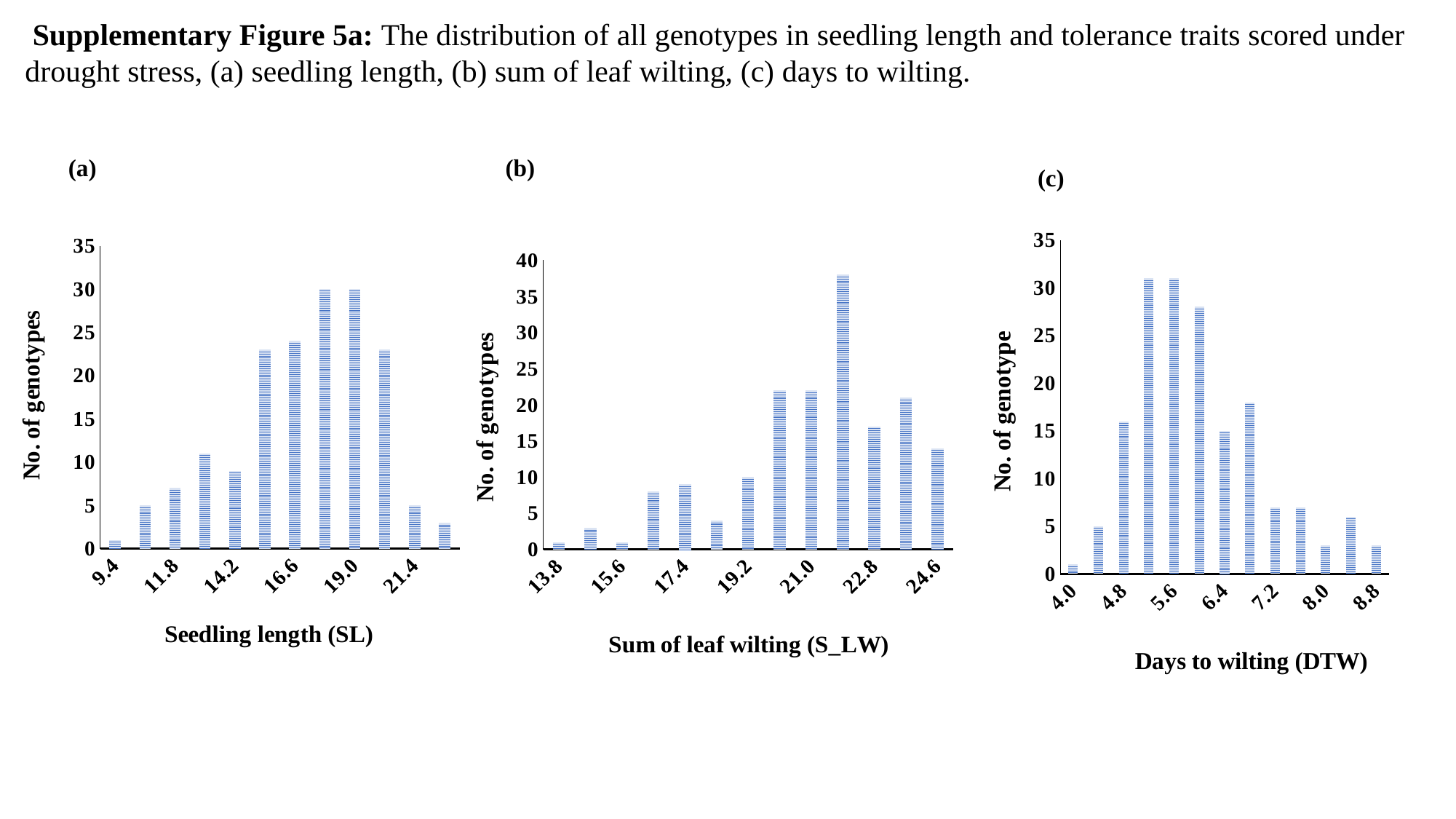
What kind of chart is chart (a), Seedling length (SL)? bar chart In chart (a), Seedling length (SL), is the number of genotypes at 19.0 greater or less than 25? greater In chart (a), Seedling length (SL), which labelled seedling length has the lowest number of genotypes? 9.4 In chart (a), Seedling length (SL), which has more genotypes: seedling length 19.0 or 11.8? 19.0 How many bars are plotted in chart (b), Sum of leaf wilting (S_LW)? 13 In chart (b), Sum of leaf wilting (S_LW), is the number of genotypes at 13.8 greater or less than 5? less In chart (a), Seedling length (SL), is the number of genotypes at 16.6 greater or less than 20? greater In chart (b), Sum of leaf wilting (S_LW), what is the highest value shown on the y axis? 40 In chart (c), Days to wilting (DTW), which labelled value has the lowest number of genotypes? 4.0 In chart (c), Days to wilting (DTW), which has more genotypes: 5.6 days or 8.0 days? 5.6